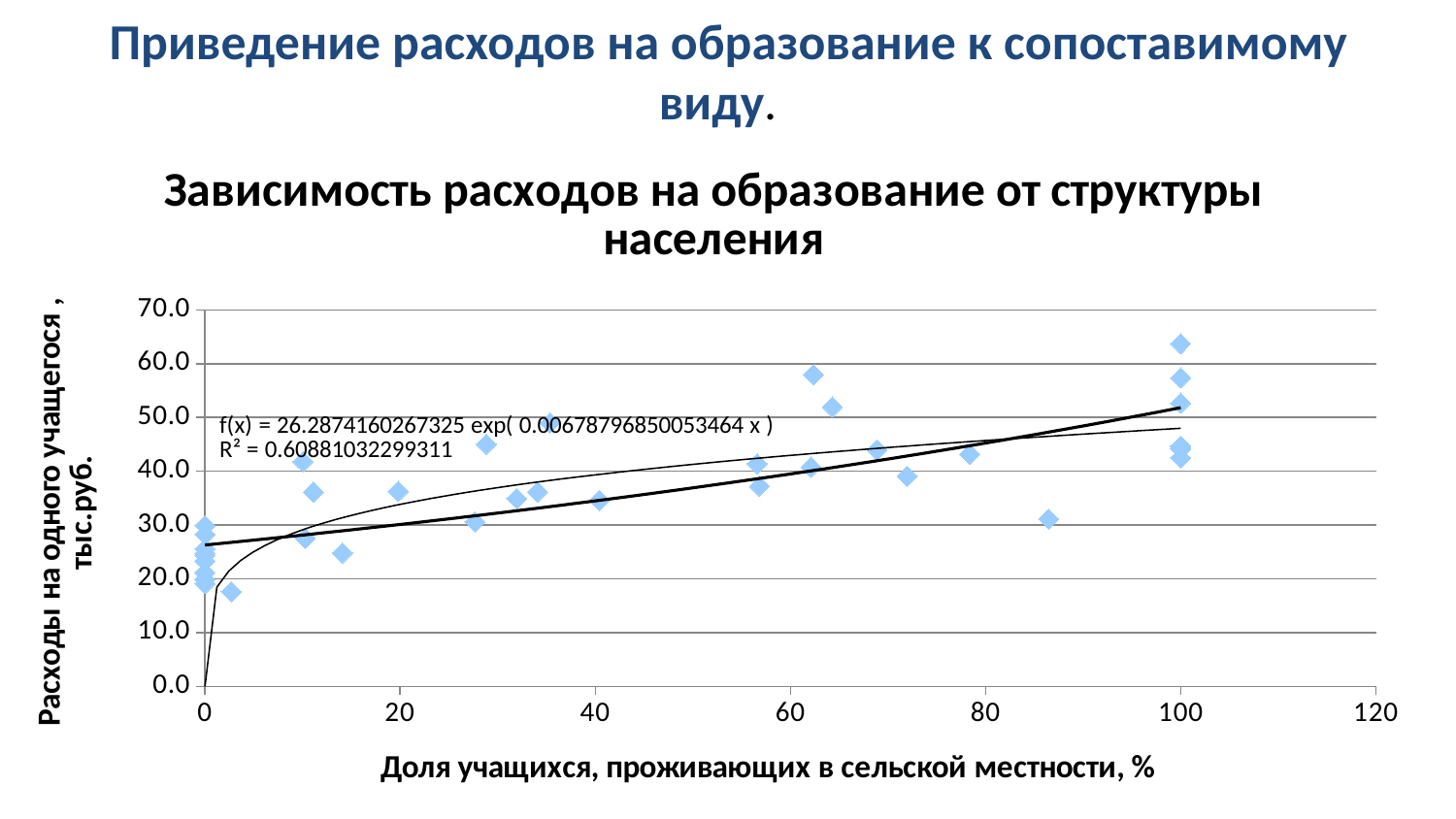
What is the constant multiplier in the fitted equation f(x) printed on the chart? 26.2874160267325 What kind of chart is shown on the slide? scatter chart What is the label of the horizontal axis of the chart? Доля учащихся, проживающих в сельской местности, % What is the maximum tick value shown on the vertical axis? 70.0 Is the point plotted near x = 3 greater or less than 20? less Is the point plotted near x = 87 greater or less than 40? less Do the plotted values generally rise or fall as the share of rural students increases along the x axis? rise Is the highest point at x = 100 greater or less than 60? greater What is the title of the chart? Зависимость расходов на образование от структуры населения What is the maximum tick value shown on the horizontal axis? 120 What R² value is printed on the chart? 0.60881032299311